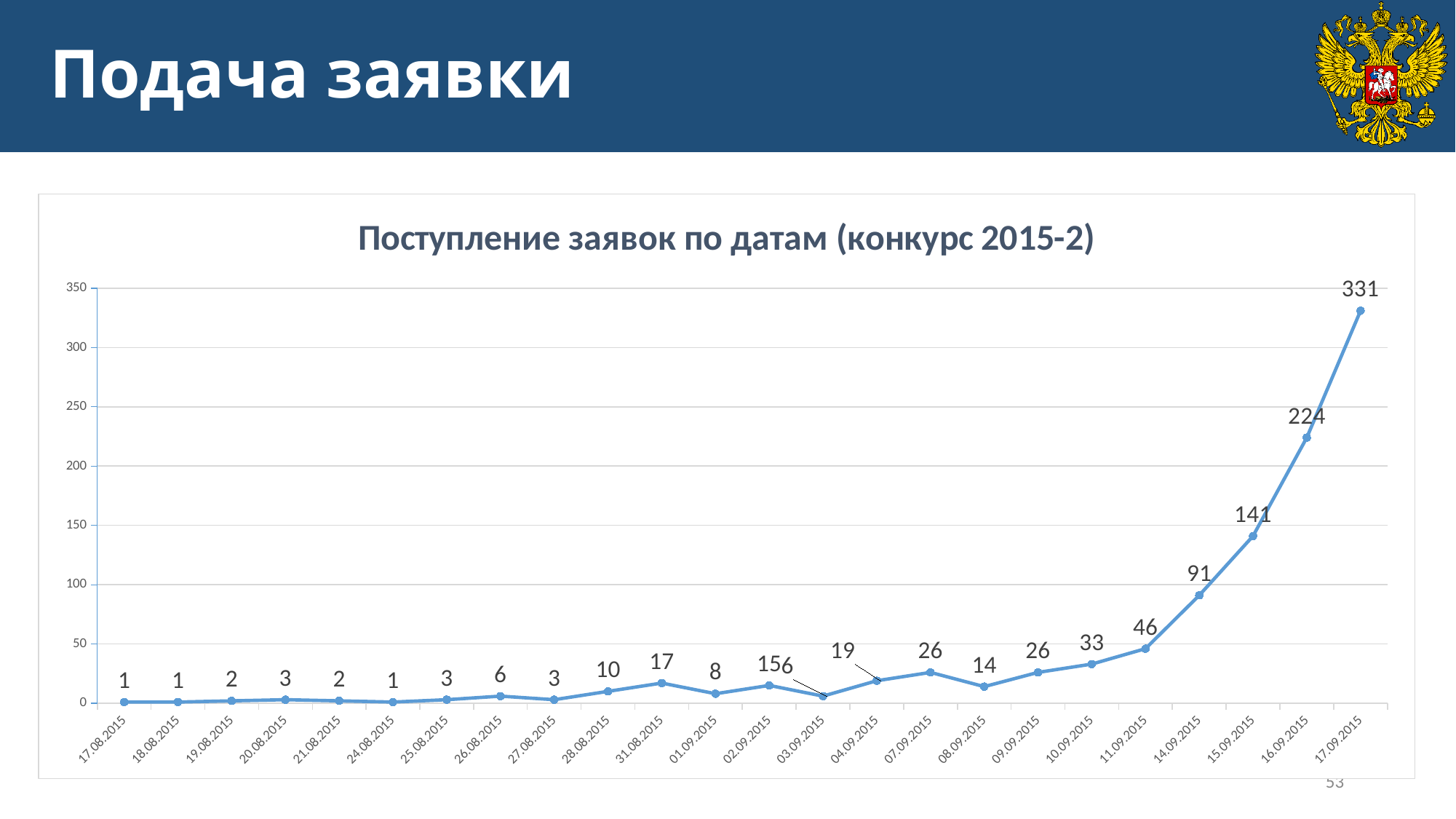
Which is larger, the value for 08.09.2015 or the value for 10.09.2015? 10.09.2015 What is the title of the chart? Поступление заявок по датам (конкурс 2015-2) What is the difference between the values for 17.09.2015 and 16.09.2015? 107 What kind of chart is shown? line chart What is the value for 11.09.2015? 46 What is the value for 17.09.2015? 331 What is the difference between the values for 14.09.2015 and 11.09.2015? 45 What is the value for 31.08.2015? 17 Which date has the highest value? 17.09.2015 What is the value for 15.09.2015? 141 How many dates are plotted on the x axis? 24 Is the value for 16.09.2015 greater or less than 200? greater